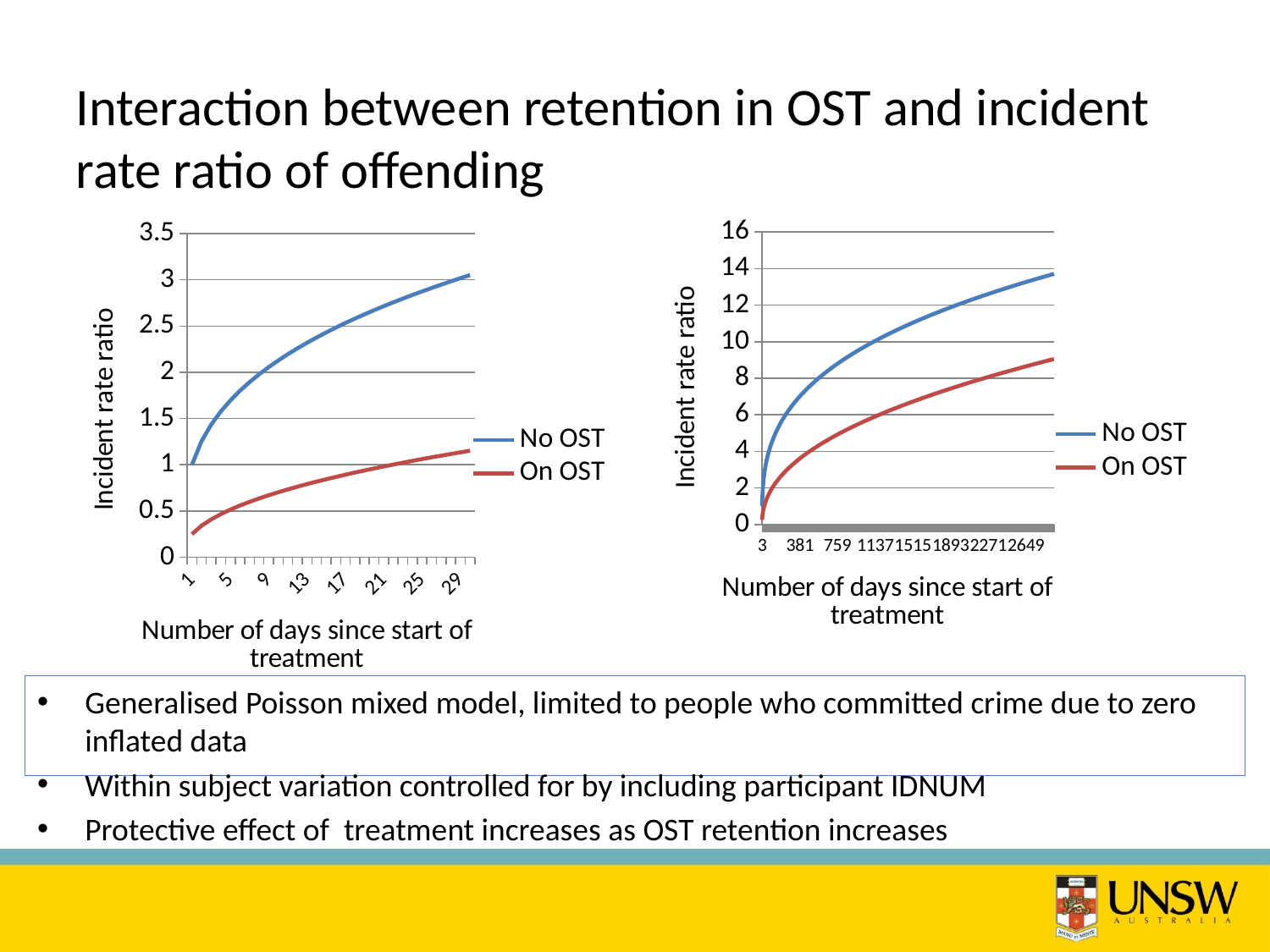
In the right chart, does the On OST line rise or fall as the number of days since start of treatment increases? rise In the right chart, which series is plotted higher across the whole x axis, No OST or On OST? No OST In the left chart, is the No OST value at day 29 greater or less than 2.5? greater In the left chart, is the On OST value at day 1 greater or less than 0.5? less What kind of chart is the left chart on the slide? line chart In the left chart, is the On OST value at day 29 greater or less than 1.5? less In the left chart, does the No OST line rise or fall as the number of days since start of treatment increases? rise How many series does the legend of the left chart list? 2 What is the y-axis title of the right chart? Incident rate ratio What kind of chart is the right chart on the slide? line chart